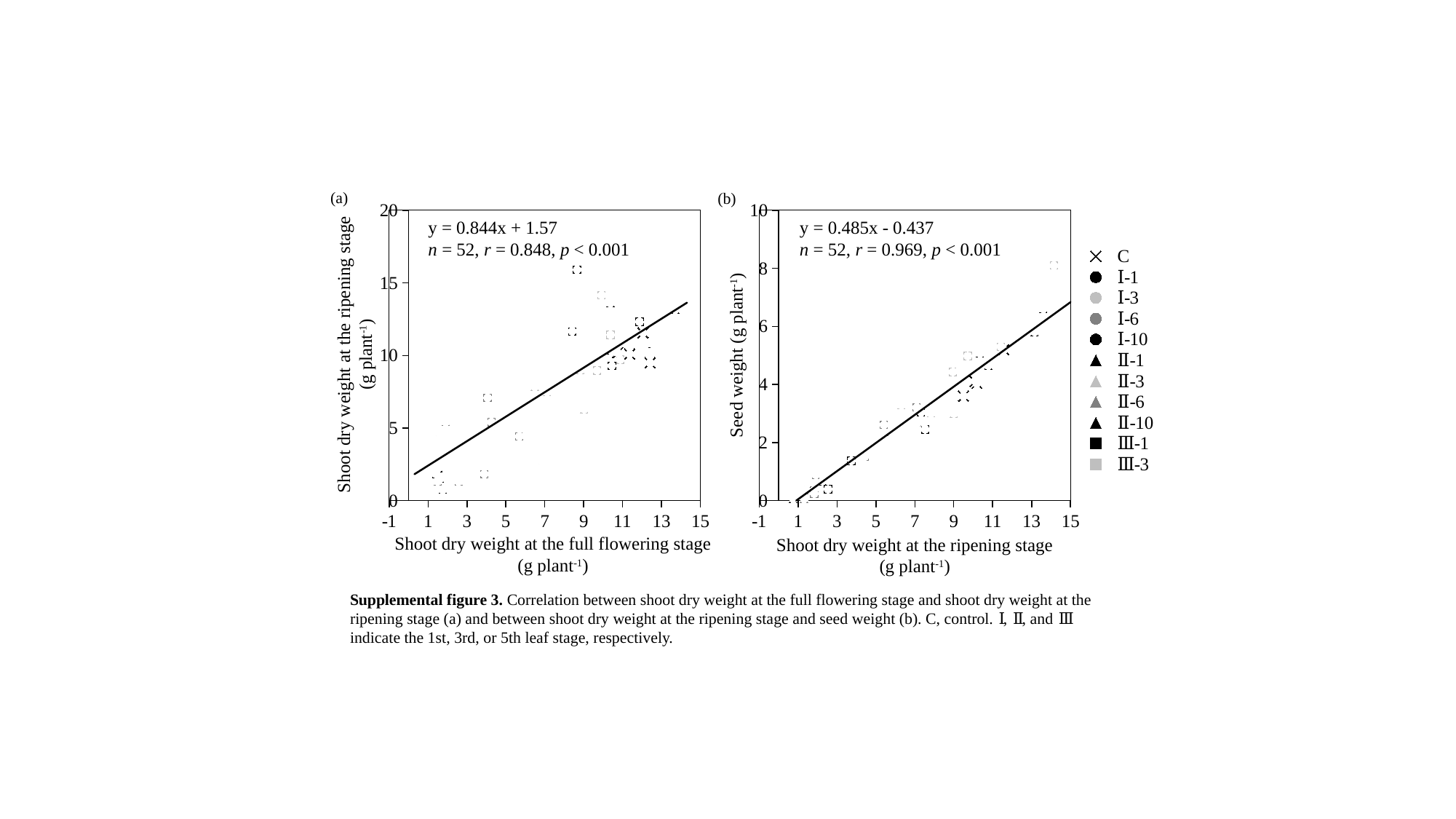
In panel (a), how many data points (n) are reported? 52 In panel (b), how many data points (n) are reported? 52 In panel (b), does seed weight rise or fall as shoot dry weight at the ripening stage increases? rise In panel (b), what is the regression equation printed on the chart? y = 0.485x - 0.437 How many series does the legend list? 11 In panel (a), what is the regression equation printed on the chart? y = 0.844x + 1.57 In panel (b), what is the correlation coefficient r? 0.969 In panel (a), does shoot dry weight at the ripening stage rise or fall as shoot dry weight at the full flowering stage increases? rise What kind of chart is panel (b)? scatter plot In panel (a), what is the correlation coefficient r? 0.848 Which panel has the higher correlation coefficient, (a) or (b)? (b) What kind of chart is panel (a)? scatter plot